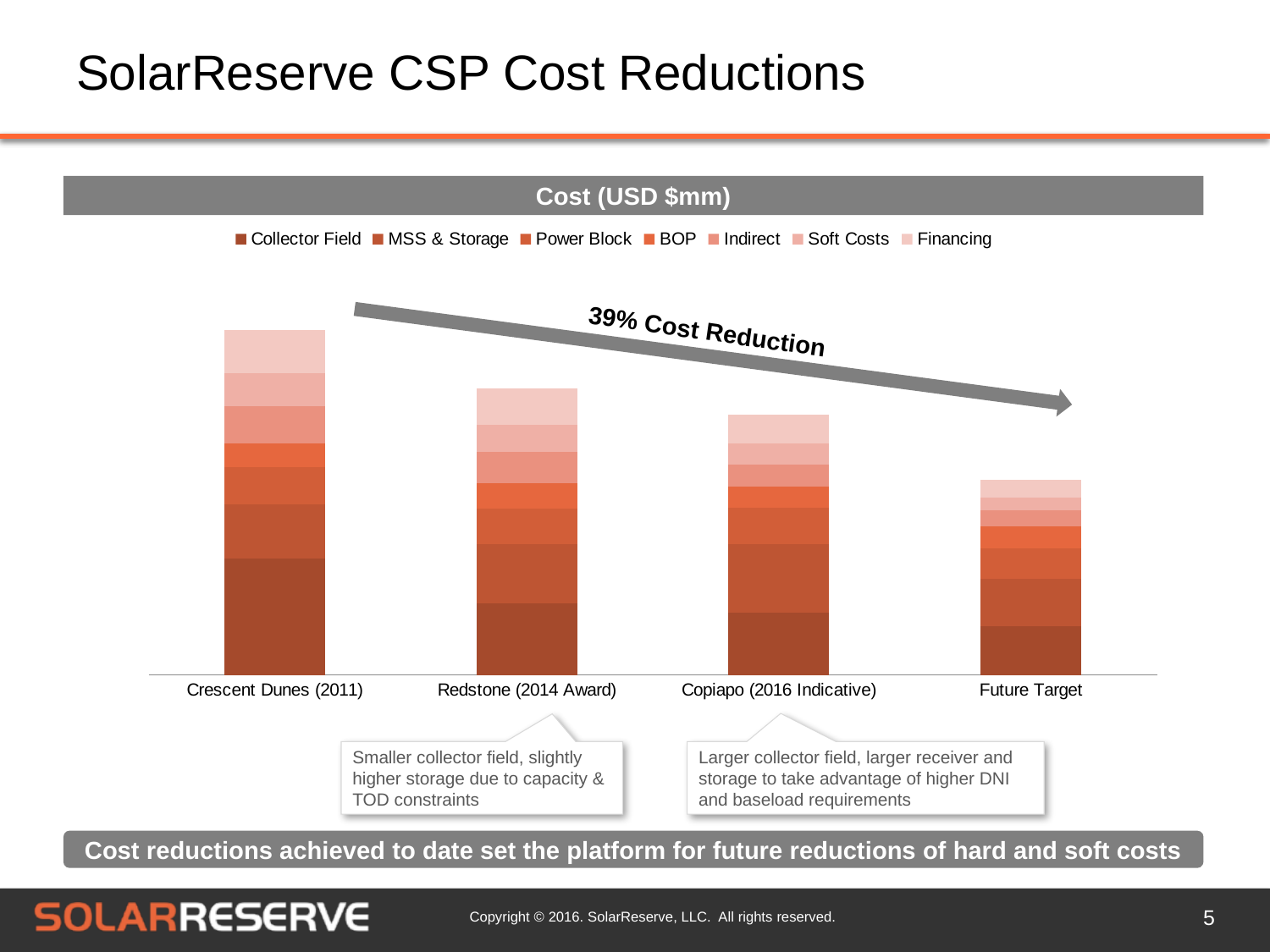
What percentage cost reduction is annotated by the arrow across the chart? 39% Do the total bar heights rise or fall moving from left to right along the x axis? Fall What kind of chart is shown on the slide? Stacked bar chart Which bar is taller, Crescent Dunes (2011) or Copiapo (2016 Indicative)? Crescent Dunes (2011) Which bar is taller, Redstone (2014 Award) or Future Target? Redstone (2014 Award) How many series does the chart's legend list? 7 Which category has the tallest (highest total cost) bar? Crescent Dunes (2011) Which category has the shortest (lowest total cost) bar? Future Target What is the title of the chart? Cost (USD $mm) How many project categories are shown along the x axis of the chart? 4